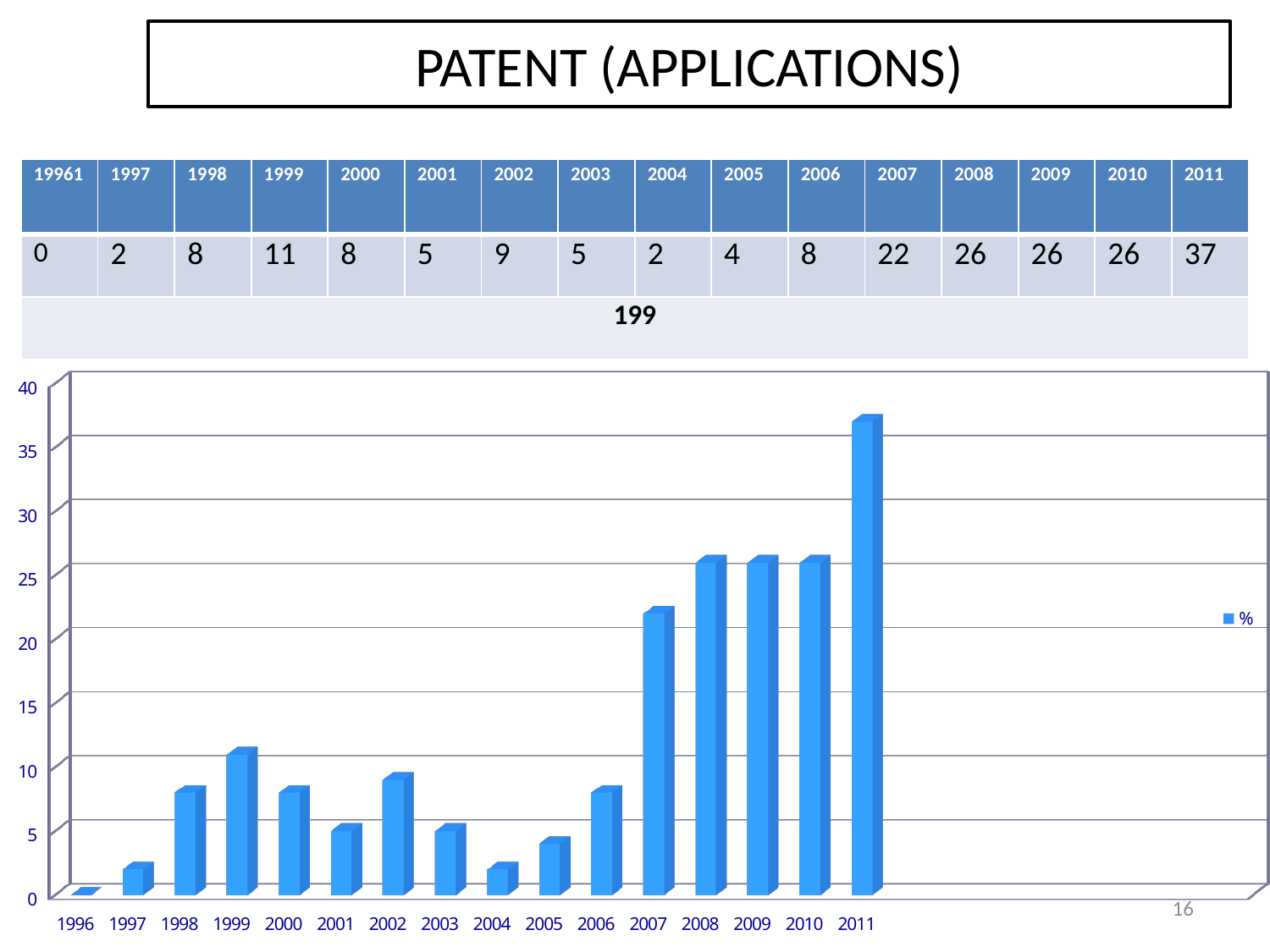
What is the legend entry for the series in the chart? % What is the value for 2007 in the chart? 22 Which year has the highest bar in the chart? 2011 What is the difference between the values for 2011 and 2010? 11 Is the value for 2007 greater or less than 20? greater Which year has the lowest bar in the chart? 1996 What is the value for 2011 in the chart? 37 Which is larger, the value for 2002 or the value for 2003? 2002 How many series does the chart legend list? 1 What is the value for 1999 in the chart? 11 What type of chart is shown on the slide? bar chart How many years are plotted along the x axis of the chart? 16